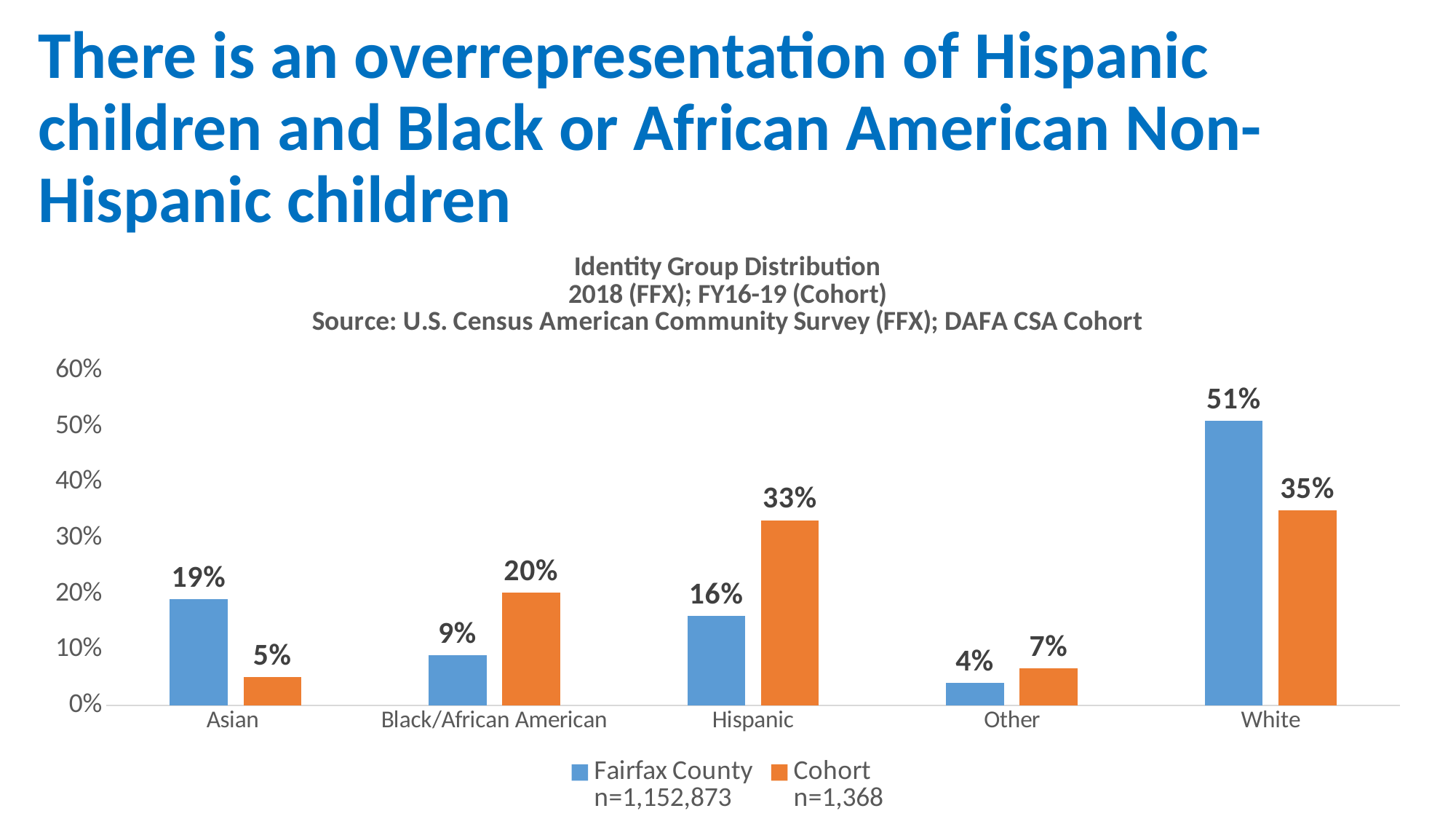
Which is larger for Other: the Fairfax County value or the Cohort value? Cohort What kind of chart is shown on the slide? Bar chart What is the sample size (n) shown for the Cohort series in the legend? n=1,368 How many series does the legend list? 2 What is the Cohort value for White? 35% What is the Cohort value for Black/African American? 20% What is the Fairfax County value for Hispanic? 16% What is the difference between the Fairfax County and Cohort values for Asian? 14% How many categories are shown on the x axis? 5 Which category has the highest Fairfax County value? White Which category has the lowest Cohort value? Asian What is the difference between the Cohort and Fairfax County values for Hispanic? 17%